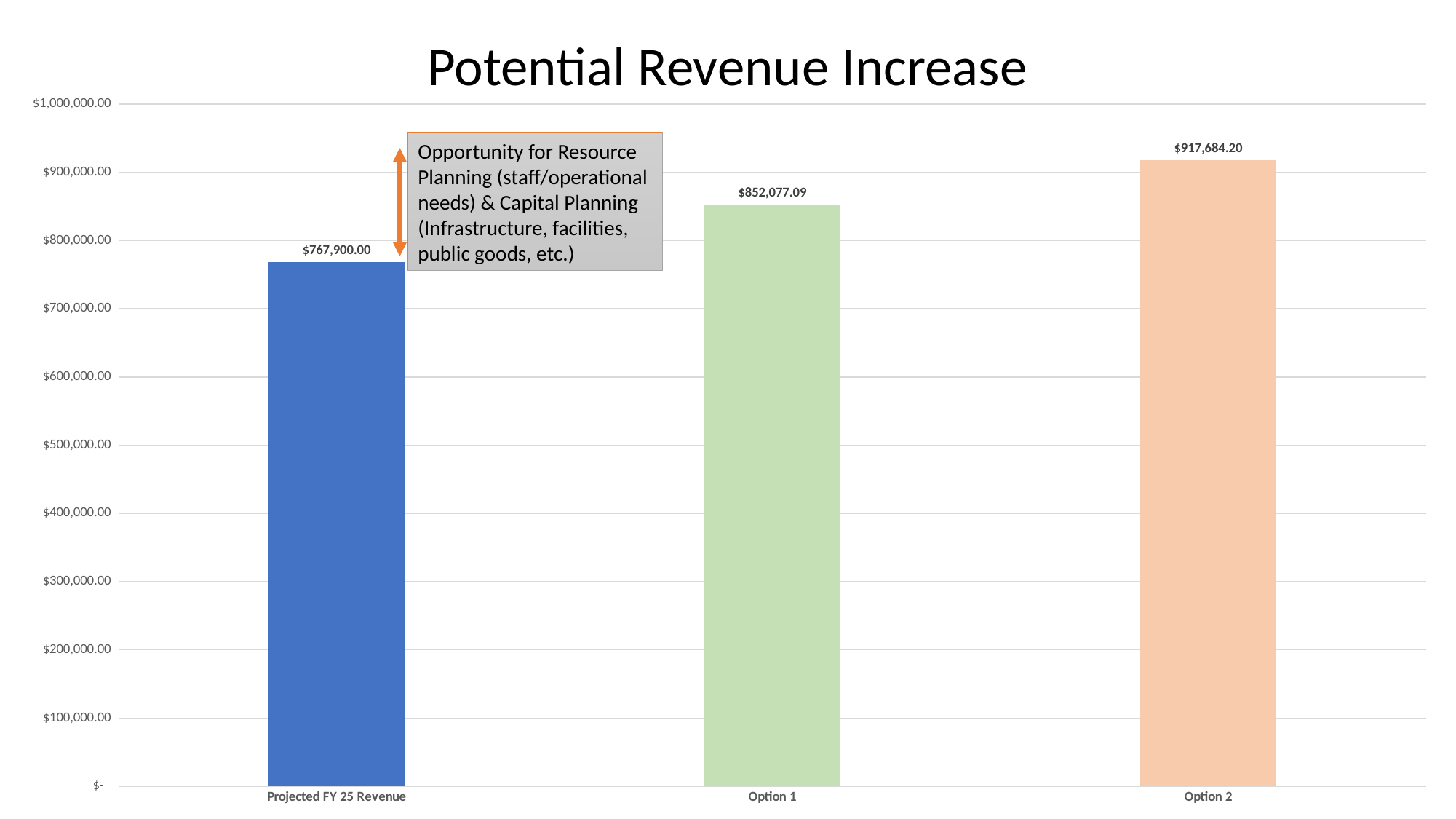
Which category has the highest value? Option 2 What is the title of the chart? Potential Revenue Increase What is the value for Projected FY 25 Revenue? $767,900.00 Which is larger, Option 1 or Option 2? Option 2 How many categories are shown on the chart? 3 What is the difference between Option 2 and Projected FY 25 Revenue? $149,784.20 What is the difference between Option 1 and Projected FY 25 Revenue? $84,177.09 Which category has the lowest value? Projected FY 25 Revenue What kind of chart is shown on the slide? bar chart What is the value for Option 1? $852,077.09 What is the value for Option 2? $917,684.20 Is the value for Option 1 greater or less than $800,000.00? greater